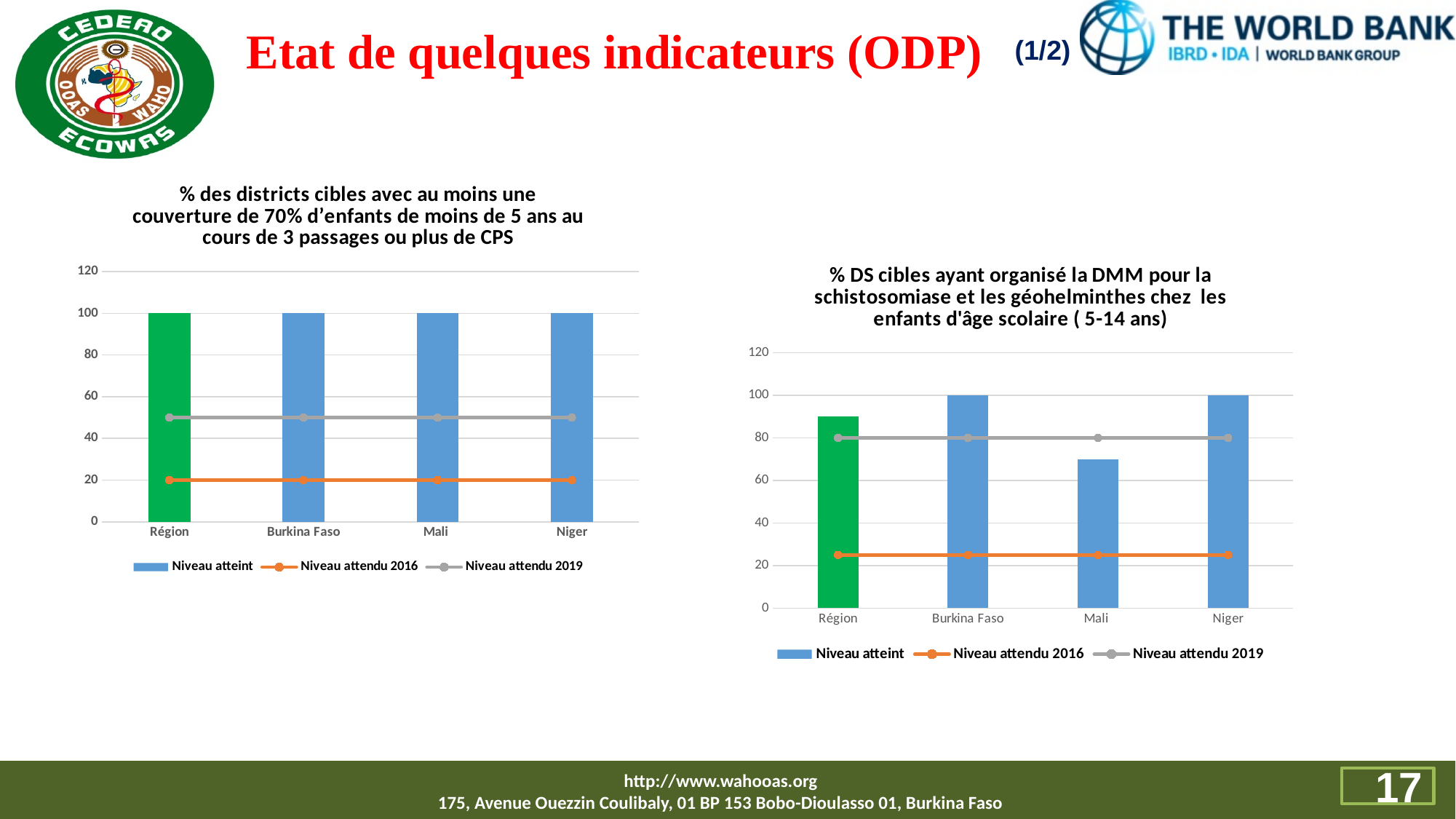
In the right chart (% DS cibles ayant organisé la DMM...), which category has the lowest 'Niveau atteint' bar? Mali In the left chart (% des districts cibles...), what is the 'Niveau attendu 2016' value for Région? 20 In the right chart (% DS cibles ayant organisé la DMM...), which has the larger 'Niveau atteint' bar, Région or Mali? Région In the right chart (% DS cibles ayant organisé la DMM...), what is the 'Niveau attendu 2019' value for Mali? 80 In the right chart (% DS cibles ayant organisé la DMM...), what is the 'Niveau atteint' value for Burkina Faso? 100 In the left chart (% des districts cibles...), what is the 'Niveau atteint' value for Mali? 100 How many categories are shown on the x axis of the left chart (% des districts cibles...)? 4 What kind of chart is the left chart titled '% des districts cibles avec au moins une couverture de 70%...'? combination bar and line chart In the left chart (% des districts cibles...), is the 'Niveau attendu 2019' value for Niger greater or less than 40? greater In the right chart (% DS cibles ayant organisé la DMM...), is the 'Niveau atteint' value for Mali greater or less than 80? less How many series does the legend of the left chart (% des districts cibles...) list? 3 In the right chart (% DS cibles ayant organisé la DMM...), what colour is the Région bar? green